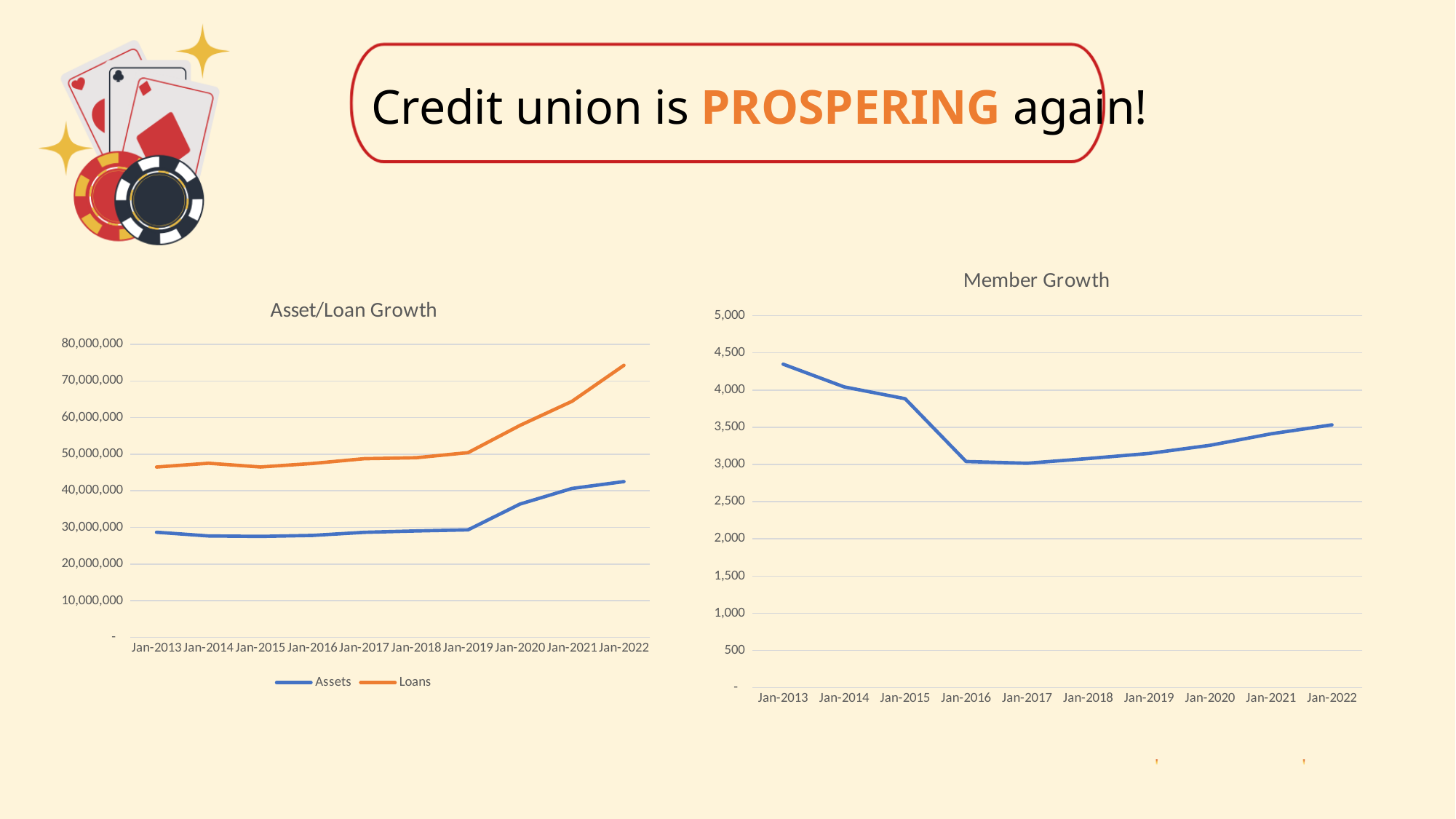
How many points along the x axis does the Asset/Loan Growth chart show? 10 In the Member Growth chart, do the values rise or fall from Jan-2013 to Jan-2016? fall How many series does the legend of the Asset/Loan Growth chart list? 2 In the Asset/Loan Growth chart, is the Loans value for Jan-2022 greater or less than 70,000,000? greater What kind of chart is the Member Growth chart? line chart In the Member Growth chart, is the value for Jan-2016 greater or less than 3,500? less In the Asset/Loan Growth chart, at which date is the Loans series highest? Jan-2022 In the Asset/Loan Growth chart, which series has the larger value at Jan-2022, Assets or Loans? Loans What kind of chart is the Asset/Loan Growth chart? line chart In the Asset/Loan Growth chart, is the Assets value for Jan-2013 greater or less than 30,000,000? less In the Asset/Loan Growth chart, do the Assets values rise or fall from Jan-2019 to Jan-2022? rise In the Member Growth chart, at which date is the value highest? Jan-2013